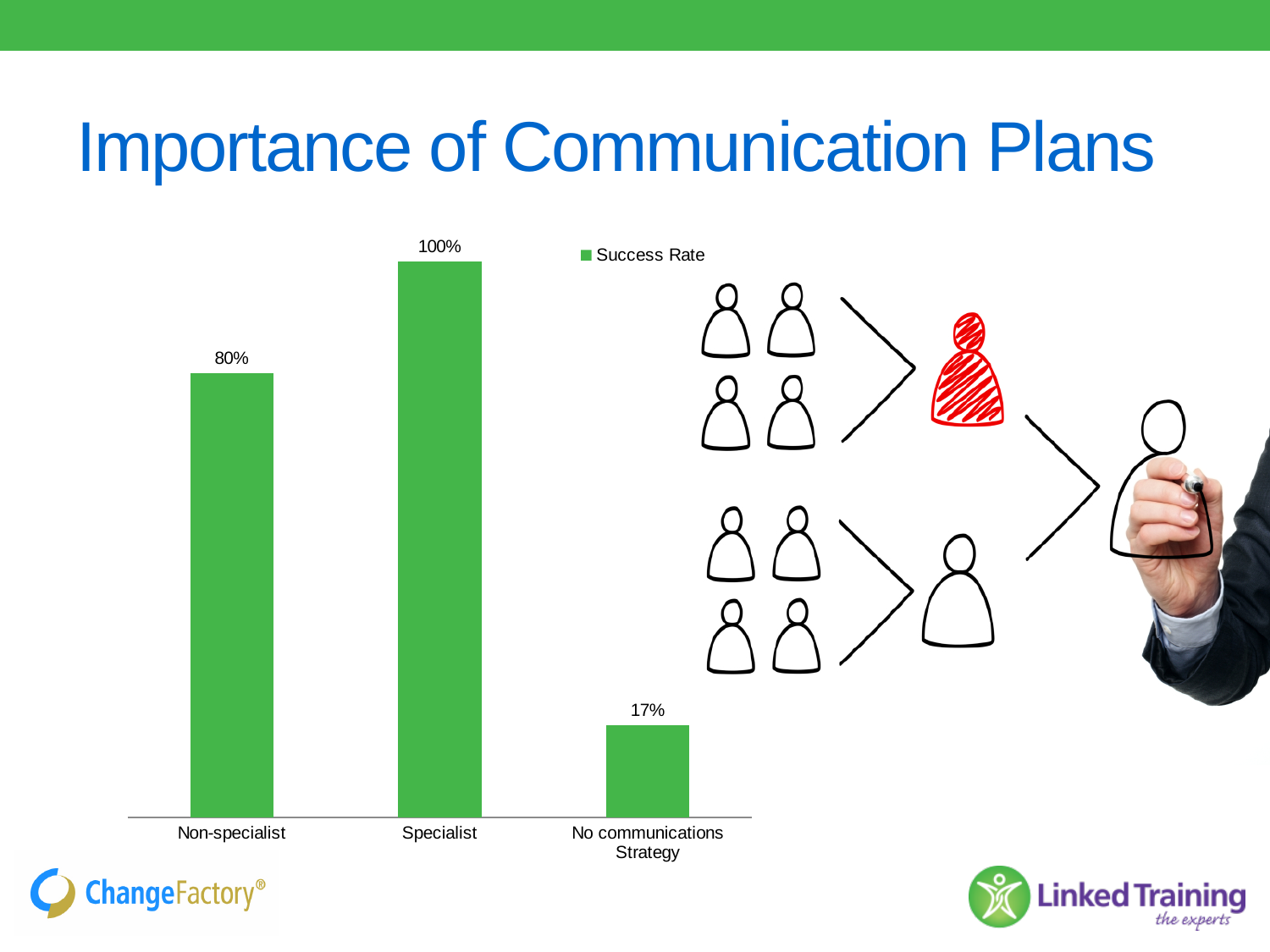
What is the Success Rate for Non-specialist? 80% What series name is shown in the chart legend? Success Rate Which has a higher Success Rate, Non-specialist or No communications Strategy? Non-specialist What is the Success Rate for No communications Strategy? 17% How many categories are shown in the chart? 3 What is the Success Rate for Specialist? 100% Which category has the highest Success Rate? Specialist How many series does the legend list? 1 What is the difference in Success Rate between Specialist and Non-specialist? 20% Which category has the lowest Success Rate? No communications Strategy What kind of chart is shown on the slide? Bar chart What is the difference in Success Rate between Non-specialist and No communications Strategy? 63%